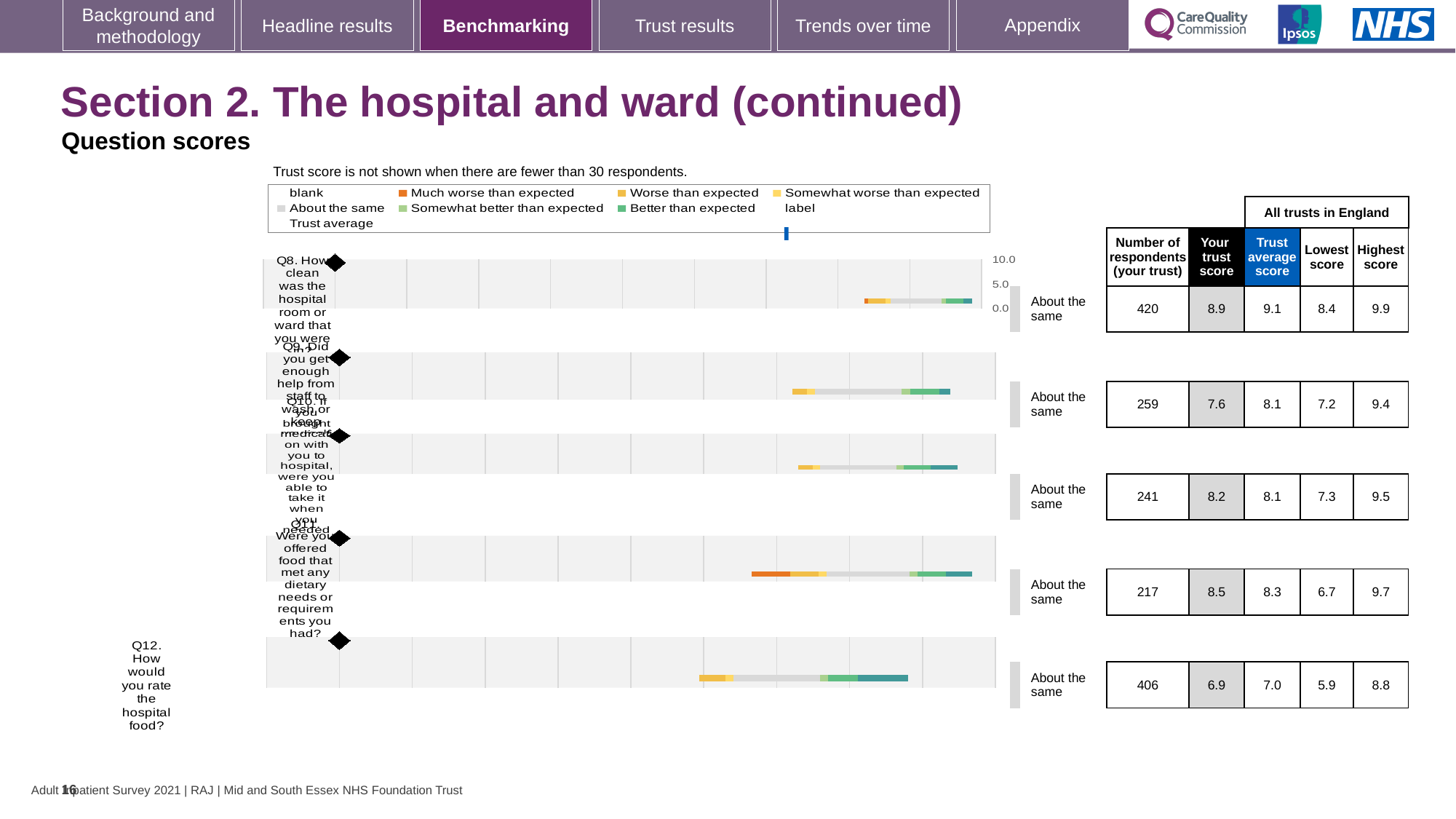
What benchmark category is shown for Q9? About the same Which question has the highest trust score? Q8 Which question has the lowest trust score? Q12 How many questions are plotted on the chart? 5 Which is larger for Q12: the trust score or the trust average score? Trust average score What is the difference between the trust average score and the trust score for Q8? 0.2 What is the highest score across all trusts in England for Q10? 9.5 What is the lowest score across all trusts in England for Q9? 7.2 What is the trust score for Q8 (how clean was the hospital room or ward)? 8.9 What is the trust average score for Q11 (offered food that met dietary needs)? 8.3 How many respondents answered Q12 (how would you rate the hospital food)? 406 What kind of chart is shown? Bar chart